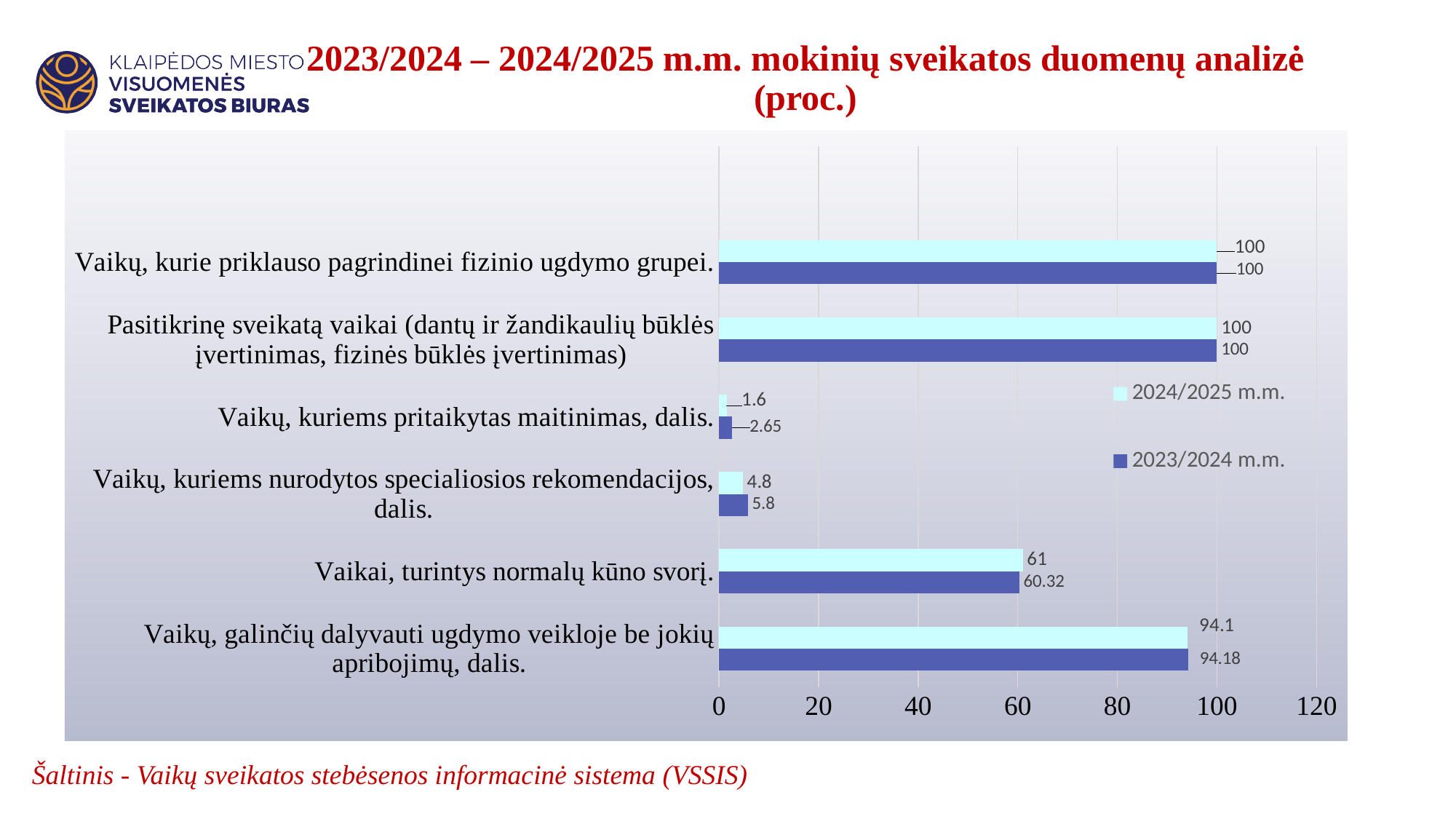
Which category has the lowest 2024/2025 m.m. value? Vaikų, kuriems pritaikytas maitinimas, dalis. How many series does the legend list? 2 How many categories are shown on the chart? 6 What kind of chart is shown on the slide? bar chart What is the difference between the 2023/2024 m.m. and 2024/2025 m.m. values for "Vaikų, kuriems pritaikytas maitinimas, dalis."? 1.05 What is the 2023/2024 m.m. value for "Vaikų, kuriems pritaikytas maitinimas, dalis."? 2.65 What is the 2024/2025 m.m. value for "Vaikai, turintys normalų kūno svorį."? 61 What is the 2023/2024 m.m. value for "Vaikų, galinčių dalyvauti ugdymo veikloje be jokių apribojimų, dalis."? 94.18 Is the 2023/2024 m.m. value for "Vaikai, turintys normalų kūno svorį." greater or less than 80? less For "Vaikai, turintys normalų kūno svorį.", which series has the larger value, 2023/2024 m.m. or 2024/2025 m.m.? 2024/2025 m.m. What is the 2024/2025 m.m. value for "Vaikų, kuriems nurodytos specialiosios rekomendacijos, dalis."? 4.8 What is the difference between the 2023/2024 m.m. and 2024/2025 m.m. values for "Vaikų, kuriems nurodytos specialiosios rekomendacijos, dalis."? 1